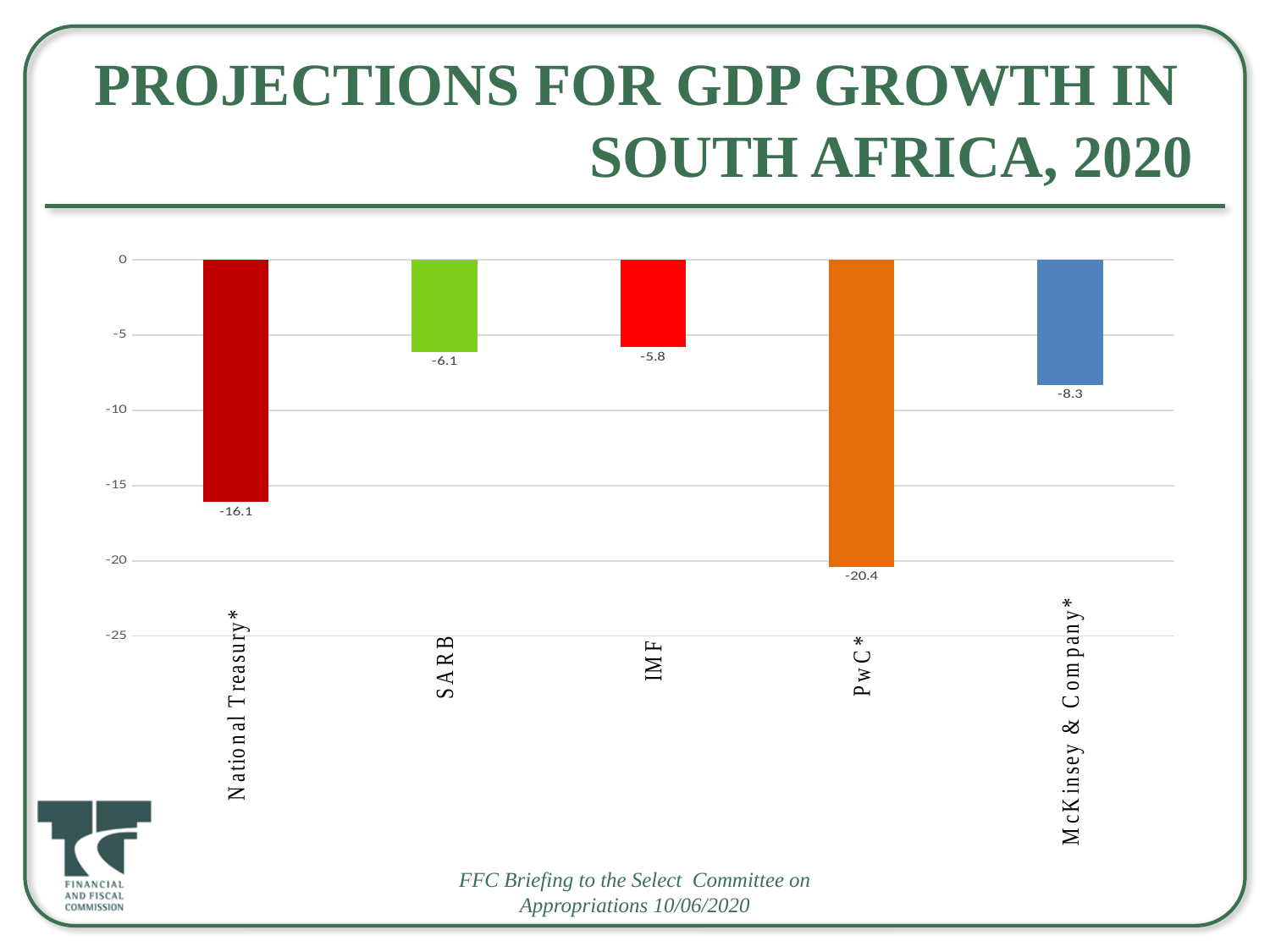
What is the difference between the McKinsey & Company* projection and the SARB projection? 2.2 How many institutions' projections are shown in the chart? 5 What is the projected GDP growth value for National Treasury*? -16.1 What is the title of the slide? PROJECTIONS FOR GDP GROWTH IN SOUTH AFRICA, 2020 Which institution has the lowest (most negative) projection? PwC* What is the projected GDP growth value for SARB? -6.1 Which projection is more negative, National Treasury* or McKinsey & Company*? National Treasury* What kind of chart is shown on the slide? Bar chart What is the difference between the PwC* projection and the National Treasury* projection? 4.3 What is the projected GDP growth value for McKinsey & Company*? -8.3 What is the projected GDP growth value for PwC*? -20.4 Which institution has the highest (least negative) projection? IMF